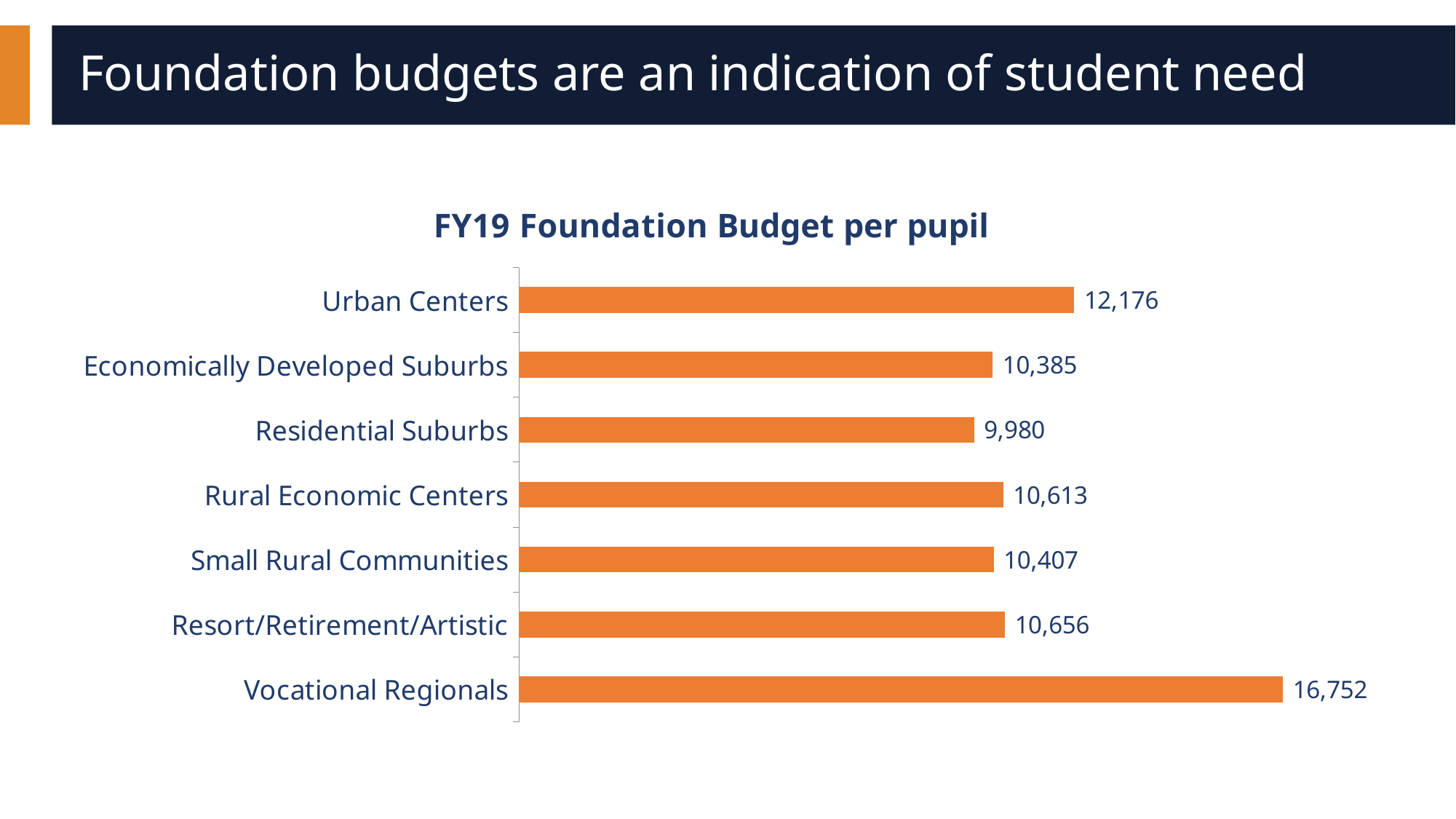
Which has a larger foundation budget per pupil, Urban Centers or Economically Developed Suburbs? Urban Centers Which category has the lowest FY19 foundation budget per pupil? Residential Suburbs What is the title of the chart? FY19 Foundation Budget per pupil What is the FY19 foundation budget per pupil for Resort/Retirement/Artistic? 10,656 What is the FY19 foundation budget per pupil for Residential Suburbs? 9,980 How many categories are shown in the chart? 7 Which category has the highest FY19 foundation budget per pupil? Vocational Regionals What is the difference between the foundation budget per pupil for Rural Economic Centers and Small Rural Communities? 206 What is the FY19 foundation budget per pupil for Urban Centers? 12,176 What is the difference between the foundation budget per pupil for Vocational Regionals and Urban Centers? 4,576 Which has a larger foundation budget per pupil, Small Rural Communities or Economically Developed Suburbs? Small Rural Communities What kind of chart is shown on the slide? Bar chart